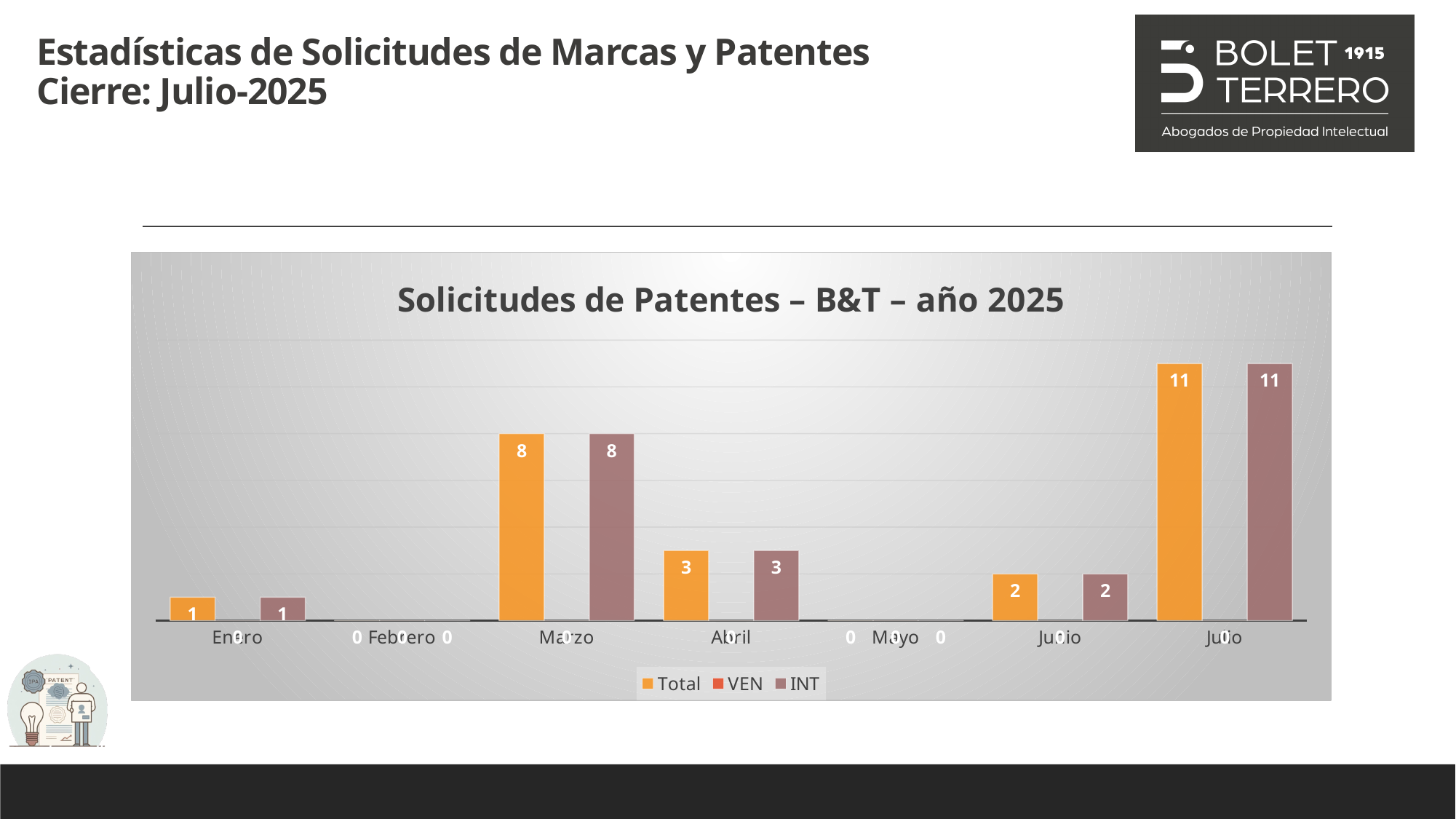
Which series is shown in orange in the legend? Total How many series does the legend list? 3 Which month has the highest Total value? Julio What type of chart is shown on the slide? bar chart What is the difference between the Total values for Julio and Marzo? 3 What is the Total value for Junio? 2 What is the title of the chart? Solicitudes de Patentes – B&T – año 2025 What is the INT value for Julio? 11 What is the Total value for Abril? 3 Which is larger, the Total value for Abril or the Total value for Junio? Abril What is the Total value for Marzo? 8 How many months are shown on the x axis? 7